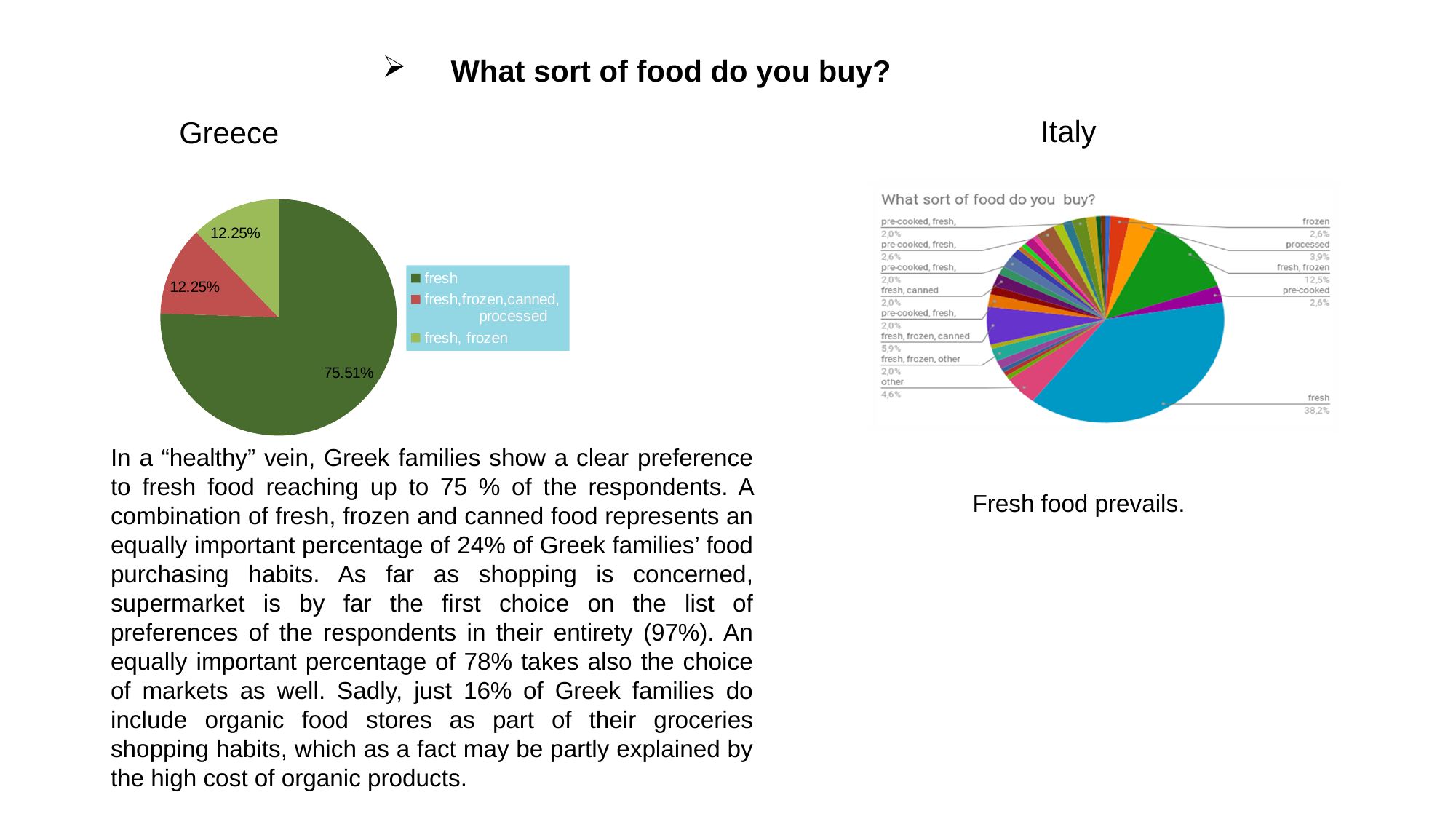
What kind of chart is the Greece chart? pie chart In the Italy chart, which is larger: fresh, frozen, canned or other? fresh, frozen, canned In the Greece chart, which colour represents fresh? dark green In the Greece chart, which category has the largest share? fresh In the Greece chart, how many entries does the legend list? 3 In the Italy chart, what percentage is shown for fresh? 38,2% In the Italy chart, what percentage is shown for fresh, frozen? 12,5% What is the title of the Italy chart? What sort of food do you buy? In the Greece chart, what is the difference between the fresh share and the fresh, frozen share? 63.26% In the Greece chart, what percentage is shown for fresh? 75.51% In the Italy chart, what percentage is shown for processed? 3,9% In the Greece chart, what percentage is shown for fresh, frozen? 12.25%